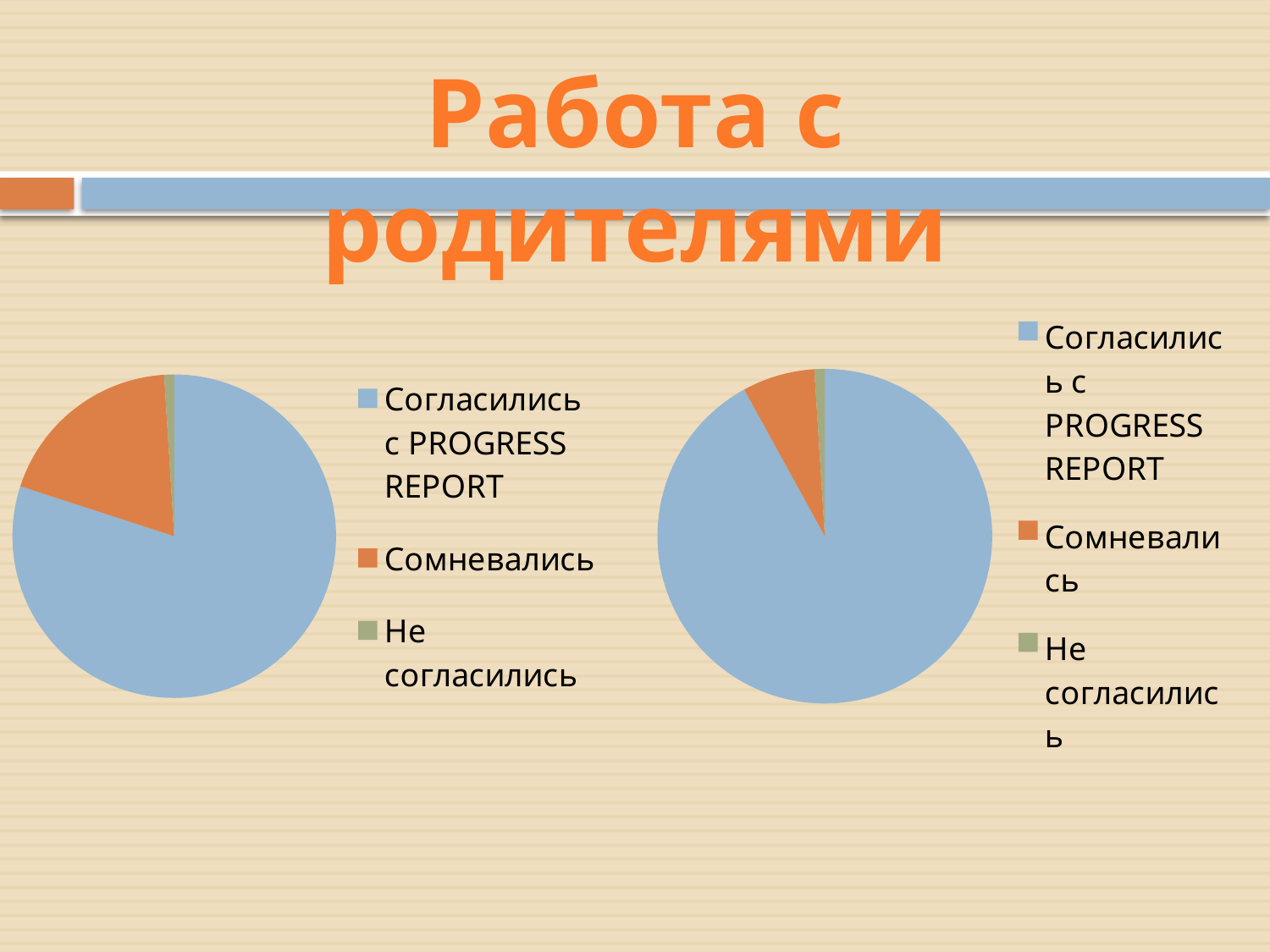
In the right pie chart, which category has the largest slice? Согласились с PROGRESS REPORT Is the Сомневались slice larger in the left pie chart or in the right pie chart? Left pie chart In the left pie chart, which slice is larger: Сомневались or Не согласились? Сомневались In the right pie chart, which category has the smallest slice? Не согласились What is the title of the slide containing the two pie charts? Работа с родителями What kind of chart is the right chart on the slide? Pie chart What colour represents Сомневались in both pie charts? Orange In the left pie chart, which category has the largest slice? Согласились с PROGRESS REPORT How many slices does the left pie chart have? 3 What kind of chart is the left chart on the slide? Pie chart In the left pie chart, which category has the smallest slice? Не согласились How many entries does the legend of the right pie chart list? 3